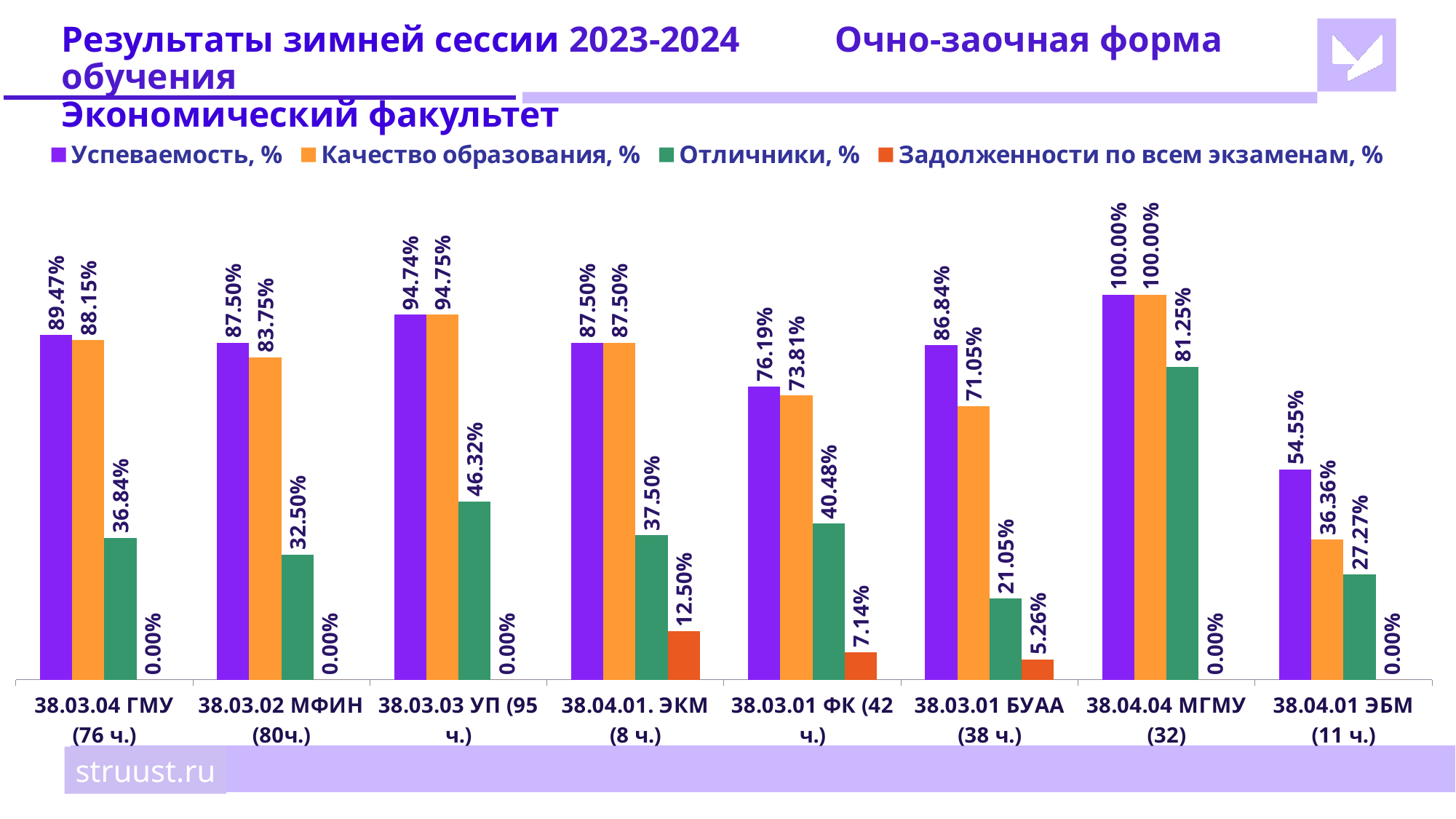
What kind of chart is shown on the slide? Bar chart What is the value of Успеваемость, % for 38.03.04 ГМУ (76 ч.)? 89.47% How many categories have a Задолженности по всем экзаменам, % value of 0.00%? 5 What is the difference between Успеваемость, % and Качество образования, % for 38.03.01 БУАА (38 ч.)? 15.79% Which category has the lowest Успеваемость, %? 38.04.01 ЭБМ (11 ч.) Which category has the highest Отличники, %? 38.04.04 МГМУ (32) Which is larger: Отличники, % for 38.03.03 УП (95 ч.) or for 38.03.01 ФК (42 ч.)? 38.03.03 УП (95 ч.) What is the value of Задолженности по всем экзаменам, % for 38.04.01. ЭКМ (8 ч.)? 12.50% How many categories are shown on the x axis? 8 How many series does the legend list? 4 What is the value of Отличники, % for 38.04.04 МГМУ (32)? 81.25% What is the value of Качество образования, % for 38.03.01 БУАА (38 ч.)? 71.05%